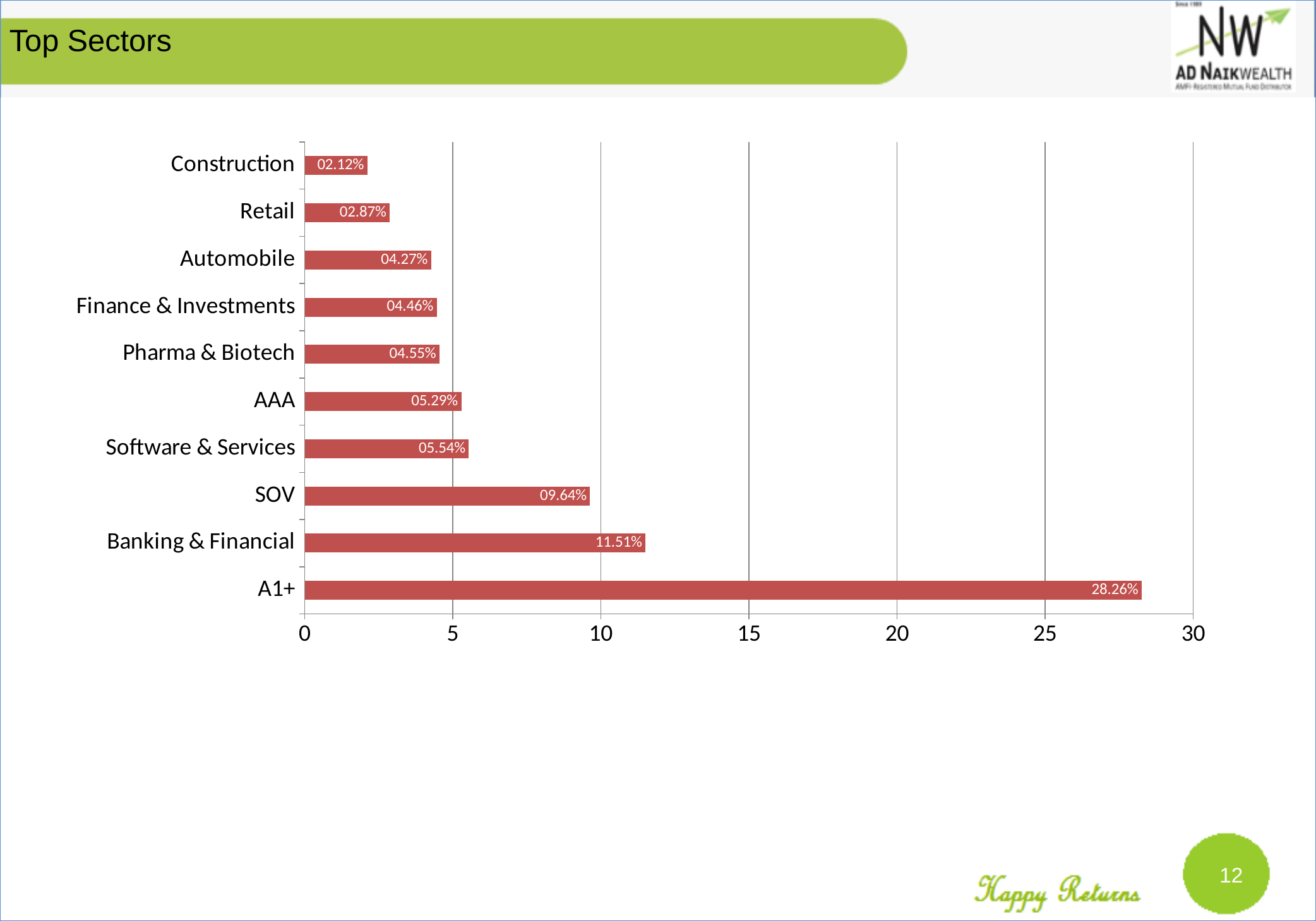
Which sector has the lowest value? Construction How many sectors are shown in the chart? 10 Which is larger, the value for SOV or the value for AAA? SOV What is the value for Banking & Financial? 11.51% What is the value for A1+? 28.26% Is the value for SOV greater or less than 10? less What is the title of the slide? Top Sectors What is the value for Software & Services? 05.54% What kind of chart is shown on the slide? bar chart What is the value for Construction? 02.12% What is the difference between the values for A1+ and Banking & Financial? 16.75% Which sector has the highest value? A1+